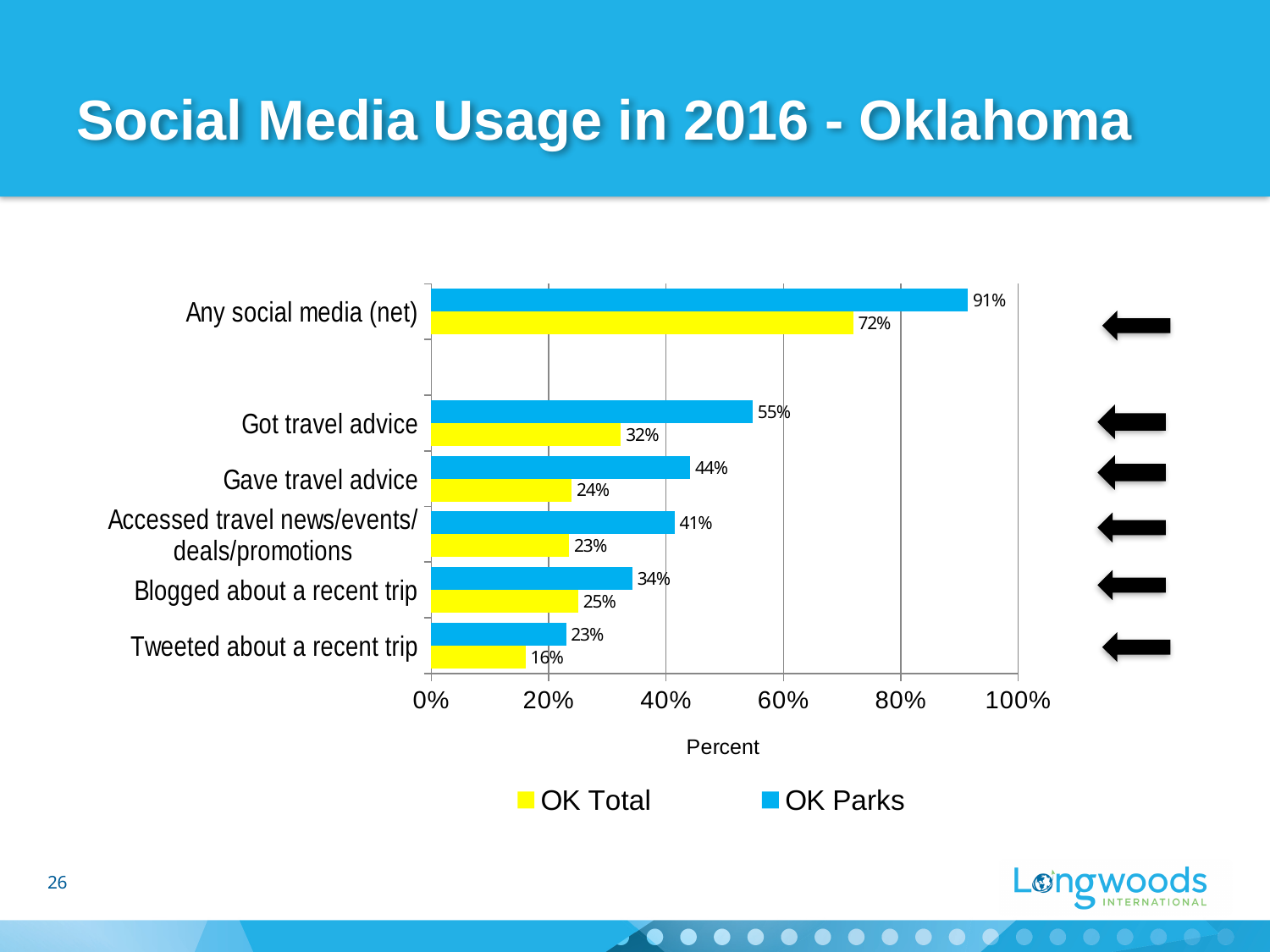
How many categories are shown on the chart? 6 What kind of chart is shown on the slide? Bar chart What is the OK Parks value for Any social media (net)? 91% How many series does the legend list? 2 Which is larger for Gave travel advice: the OK Parks value or the OK Total value? OK Parks Which category has the highest OK Parks value? Any social media (net) Is the OK Total value for Any social media (net) greater or less than 60%? greater What is the OK Total value for Got travel advice? 32% What is the OK Parks value for Blogged about a recent trip? 34% What is the difference between the OK Parks and OK Total values for Got travel advice? 23% Which category has the lowest OK Total value? Tweeted about a recent trip What is the title of the chart on the slide? Social Media Usage in 2016 - Oklahoma